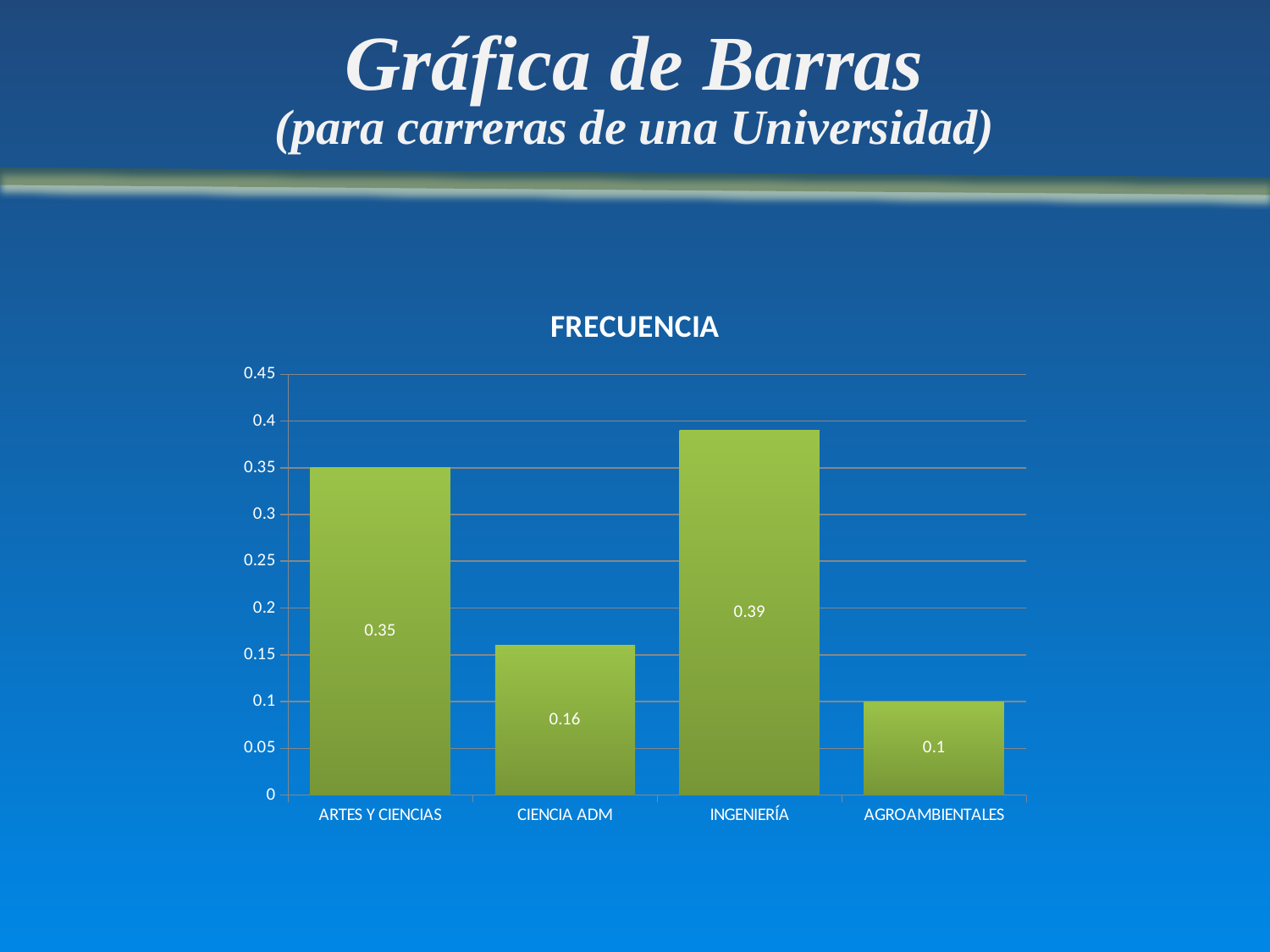
What is the value for ARTES Y CIENCIAS? 0.35 What kind of chart is shown on the slide? Bar chart What is the difference between the values for CIENCIA ADM and AGROAMBIENTALES? 0.06 Which category has the lowest value? AGROAMBIENTALES What is the difference between the values for INGENIERÍA and ARTES Y CIENCIAS? 0.04 What is the title of the chart? FRECUENCIA Which is larger, the value for ARTES Y CIENCIAS or the value for CIENCIA ADM? ARTES Y CIENCIAS How many categories are shown in the chart? 4 What is the value for AGROAMBIENTALES? 0.1 Which category has the highest value? INGENIERÍA What is the value for INGENIERÍA? 0.39 What is the value for CIENCIA ADM? 0.16